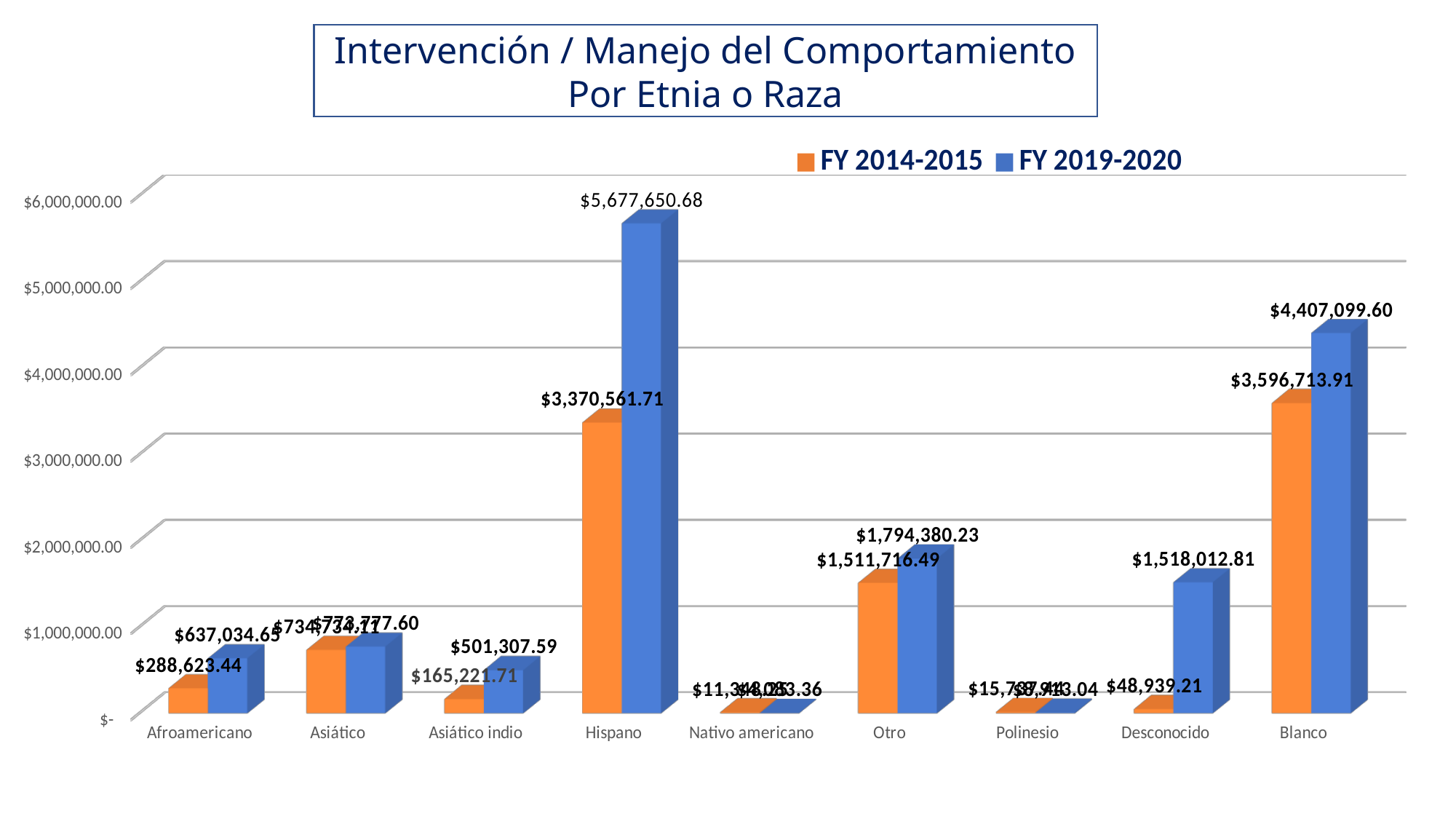
What is the difference between the FY 2019-2020 and FY 2014-2015 values for Hispano? $2,307,088.97 Which is larger for Otro: the FY 2014-2015 value or the FY 2019-2020 value? FY 2019-2020 Which category has the highest FY 2019-2020 value? Hispano What is the FY 2014-2015 value for Blanco? $3,596,713.91 What kind of chart is shown on the slide? Bar chart What is the FY 2014-2015 value for Afroamericano? $288,623.44 What is the FY 2019-2020 value for Desconocido? $1,518,012.81 How many categories are shown on the x axis? 9 What is the FY 2019-2020 value for Hispano? $5,677,650.68 How many series does the legend list? 2 What is the difference between the FY 2019-2020 and FY 2014-2015 values for Blanco? $810,385.69 Which category has the highest FY 2014-2015 value? Blanco